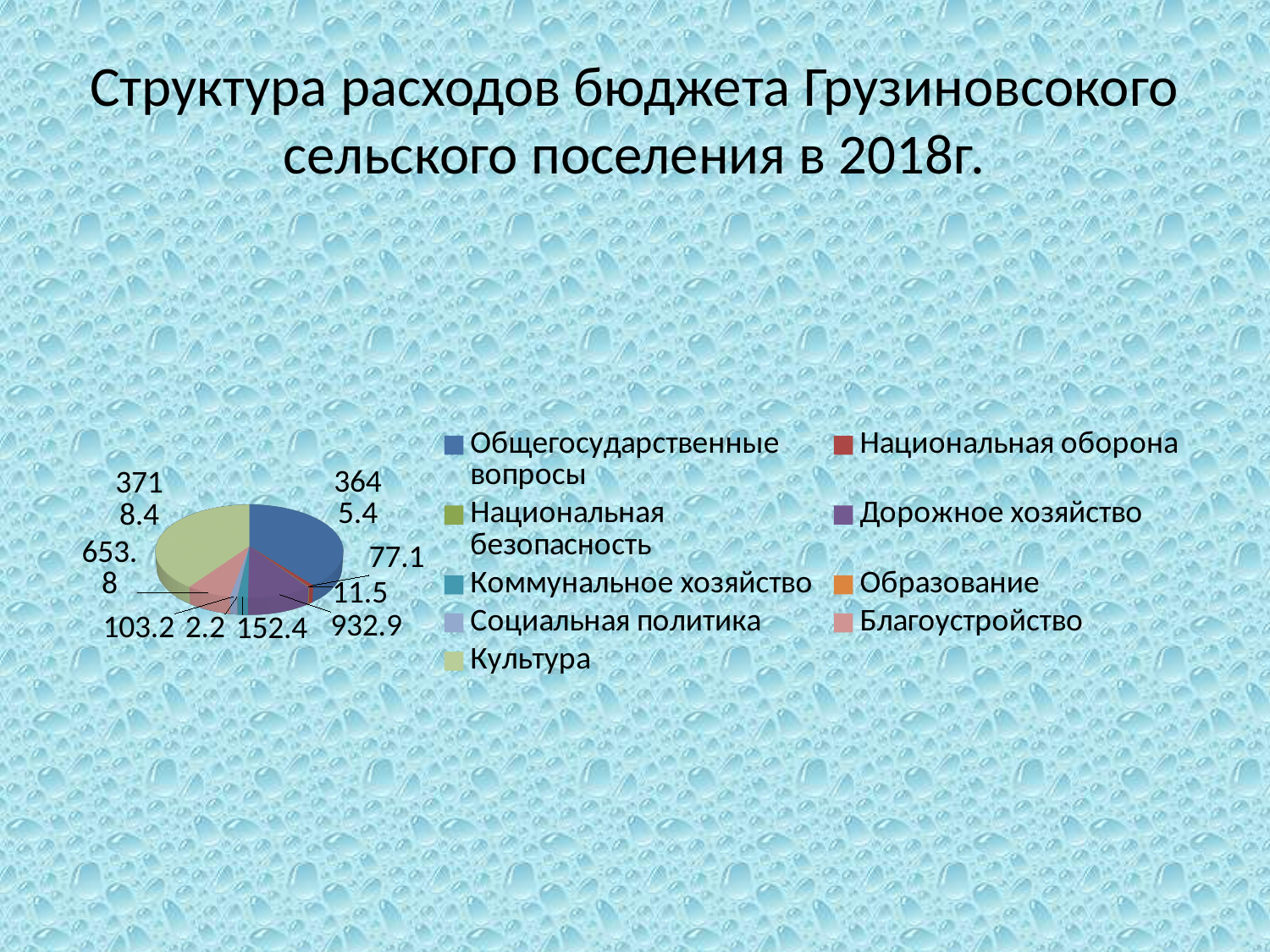
What is the difference between the labelled values for Дорожное хозяйство (932.9) and Благоустройство (653.8) on the pie chart? 279.1 What kind of chart is shown on the slide? pie chart What value is labelled on the red slice (Национальная оборона) of the pie chart? 77.1 Which is larger on the pie chart: the value for Дорожное хозяйство (932.9) or the value for Благоустройство (653.8)? Дорожное хозяйство What is the title of the slide with the pie chart? Структура расходов бюджета Грузиновсокого сельского поселения в 2018г. Which legend entry is shown in blue on the pie chart? Общегосударственные вопросы What value is labelled on the blue slice (Общегосударственные вопросы) of the pie chart? 3645.4 What is the smallest value labelled on the pie chart? 2.2 What value is labelled on the purple slice (Дорожное хозяйство) of the pie chart? 932.9 What value is labelled on the green slice (Культура) of the pie chart? 3718.4 What value is labelled on the pink slice (Благоустройство) of the pie chart? 653.8 How many categories does the legend of the pie chart list? 9